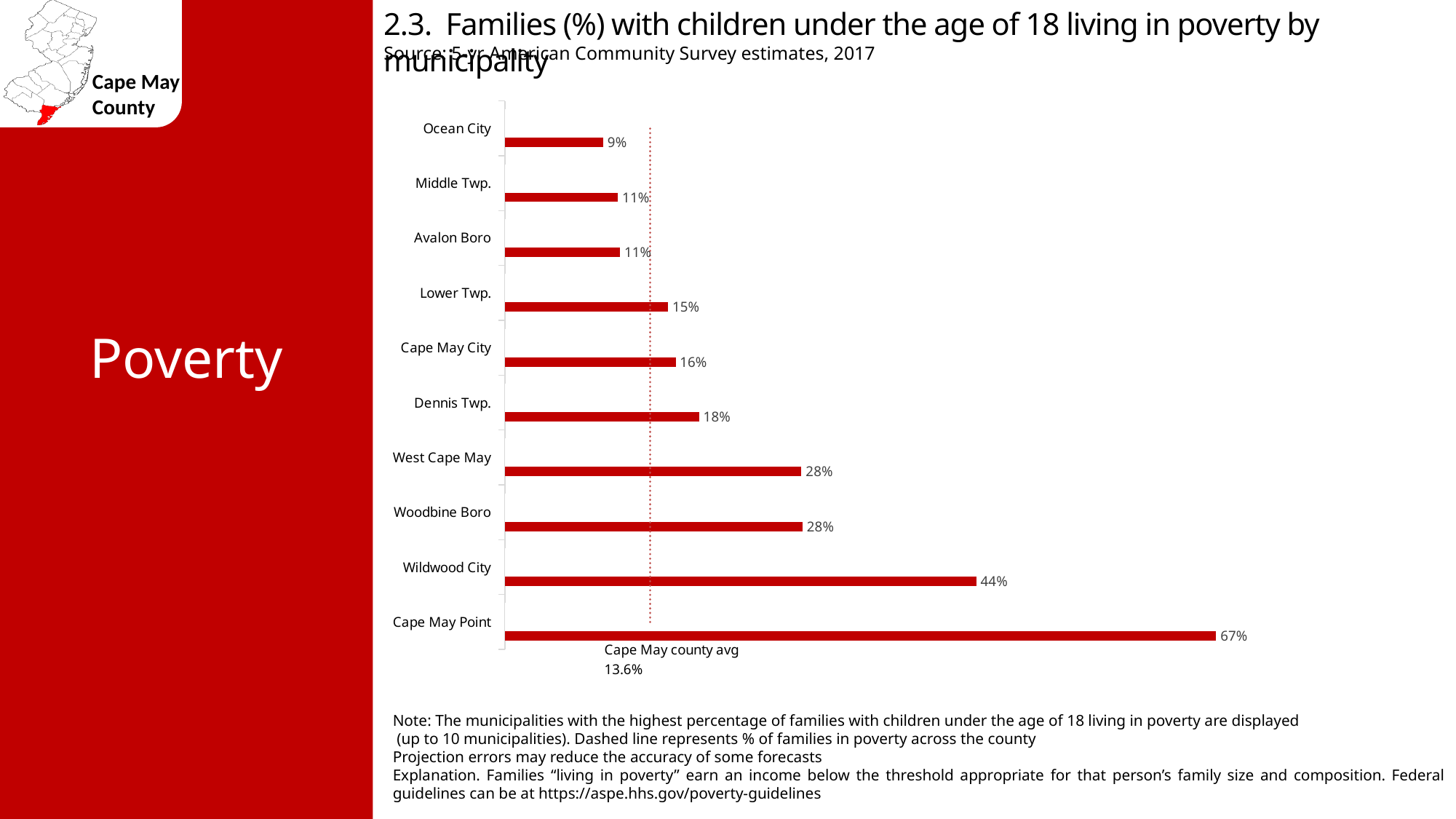
What is the difference between the values for Lower Twp. and Ocean City? 6% Which two municipalities both have a value of 28%? West Cape May and Woodbine Boro What is the Cape May county average shown by the dashed line? 13.6% What percentage of families with children under 18 are living in poverty in Wildwood City? 44% Which municipality has the lowest percentage shown on the chart? Ocean City Which has a higher value, Cape May City or West Cape May? West Cape May How many municipalities are shown on the chart? 10 What is the value shown for Ocean City? 9% What is the difference between the values for Cape May Point and Wildwood City? 23% Which municipality has the highest percentage of families with children under 18 living in poverty? Cape May Point What kind of chart is shown on the slide? Bar chart What is the value shown for Dennis Twp.? 18%